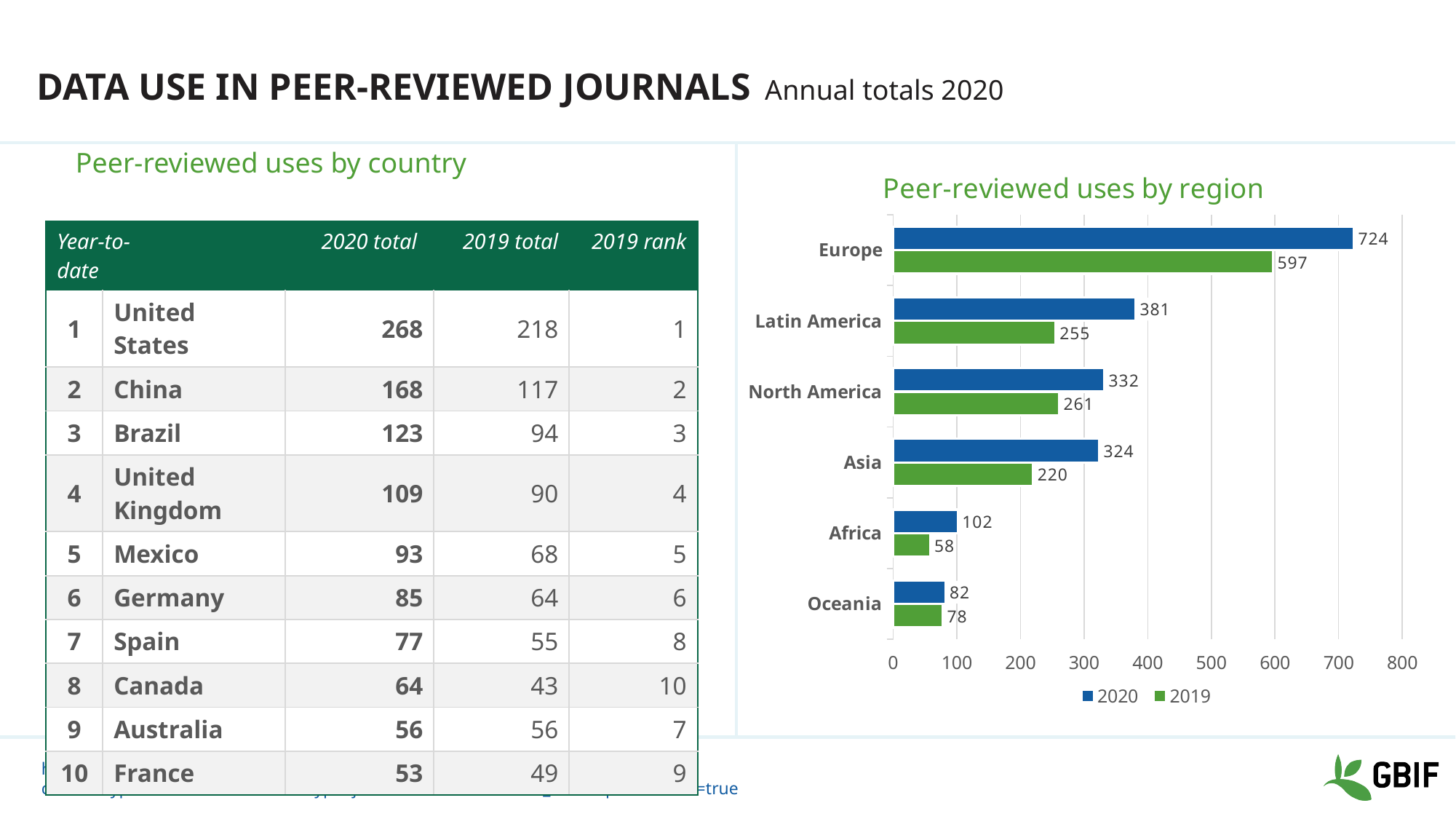
In the 'Peer-reviewed uses by region' chart, what is the 2019 value for Latin America? 255 In the 'Peer-reviewed uses by region' chart, what is the difference between the 2020 and 2019 values for Europe? 127 In the 'Peer-reviewed uses by region' chart, what is the difference between the 2020 values for North America and Asia? 8 In the 'Peer-reviewed uses by region' chart, how many series does the legend list? 2 In the 'Peer-reviewed uses by region' chart, what is the 2020 value for Africa? 102 In the 'Peer-reviewed uses by region' chart, which colour represents the 2019 series? Green In the 'Peer-reviewed uses by region' chart, what is the 2020 value for Europe? 724 In the 'Peer-reviewed uses by region' chart, which region has the highest 2020 value? Europe In the 'Peer-reviewed uses by region' chart, which is larger: the 2020 value for Latin America or the 2020 value for North America? Latin America What type of chart is 'Peer-reviewed uses by region'? Bar chart In the 'Peer-reviewed uses by region' chart, which region has the lowest 2019 value? Africa In the 'Peer-reviewed uses by region' chart, how many regions are shown? 6